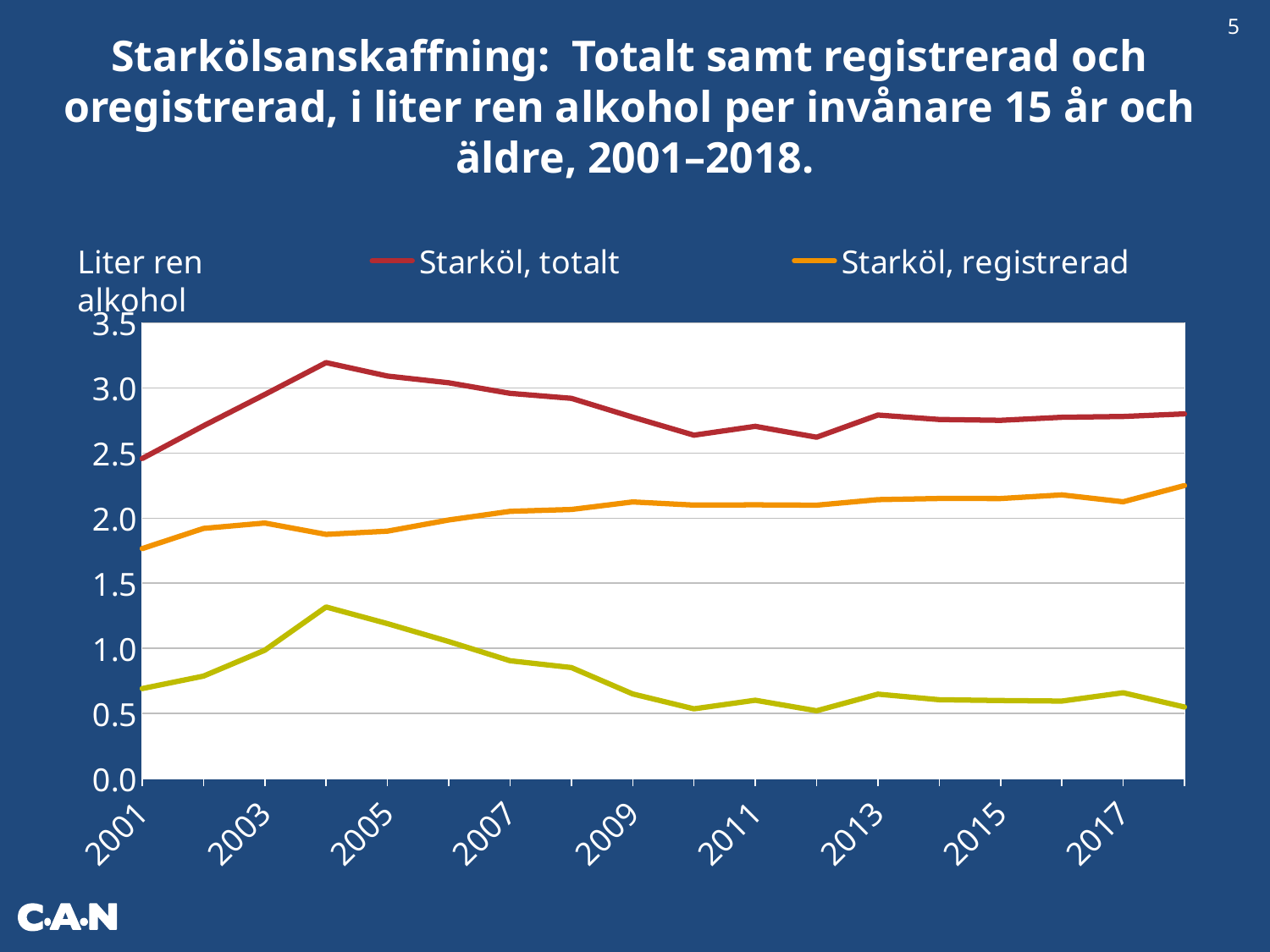
In which year is the Starköl, registrerad series at its lowest value? 2001 In which year does the Starköl, totalt series reach its highest value? 2004 Is the value for Starköl, registrerad in 2018 greater or less than 2.0? greater Is the value for Starköl, totalt in 2010 greater or less than 2.5? greater Is the value for Starköl, registrerad in 2001 greater or less than 2.0? less Which series does the legend show in red? Starköl, totalt Does the Starköl, totalt series rise or fall between 2004 and 2010? Fall What is the label on the y axis of the chart? Liter ren alkohol How many series does the legend list? 2 Which is larger in 2013, Starköl, totalt or Starköl, registrerad? Starköl, totalt What kind of chart is shown on the slide? Line chart